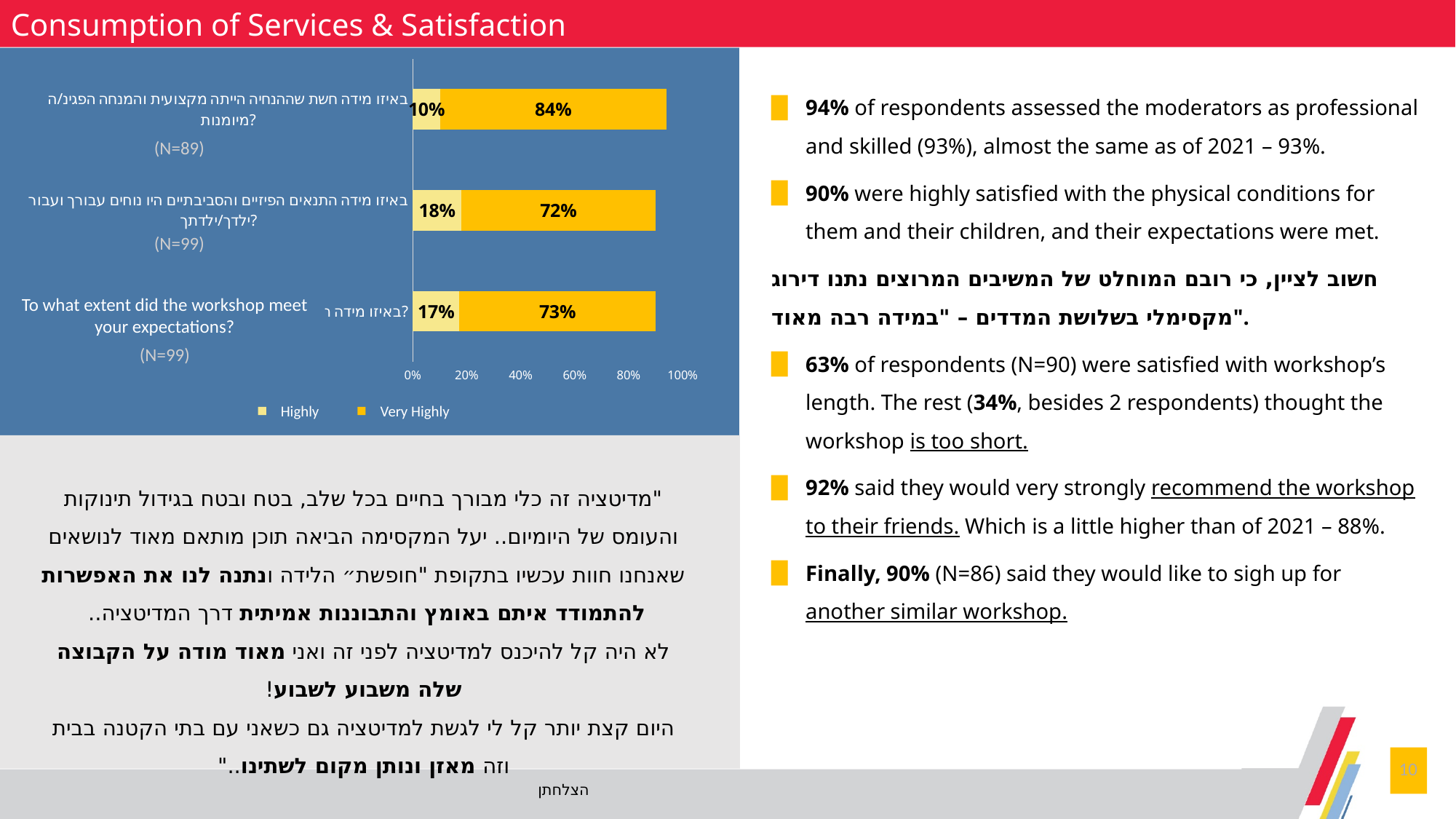
What is the combined total of 'Highly' and 'Very Highly' for 'To what extent did the workshop meet your expectations?' 90% Which bar has the lowest 'Highly' value? the top bar (N=89) What is the 'Highly' value for the middle bar in the chart? 18% Which bar has the highest 'Very Highly' value? the top bar (N=89) What is the 'Highly' value for 'To what extent did the workshop meet your expectations?' 17% What is the difference between the 'Very Highly' values of the top bar and the middle bar? 12% What kind of chart is shown on the slide? bar chart How many series does the chart legend list? 2 How many categories (bars) are plotted in the chart? 3 What is the 'Very Highly' value for 'To what extent did the workshop meet your expectations?' 73% Which series is shown in the darker yellow colour in the chart? Very Highly What is the 'Very Highly' value for the top bar in the chart? 84%